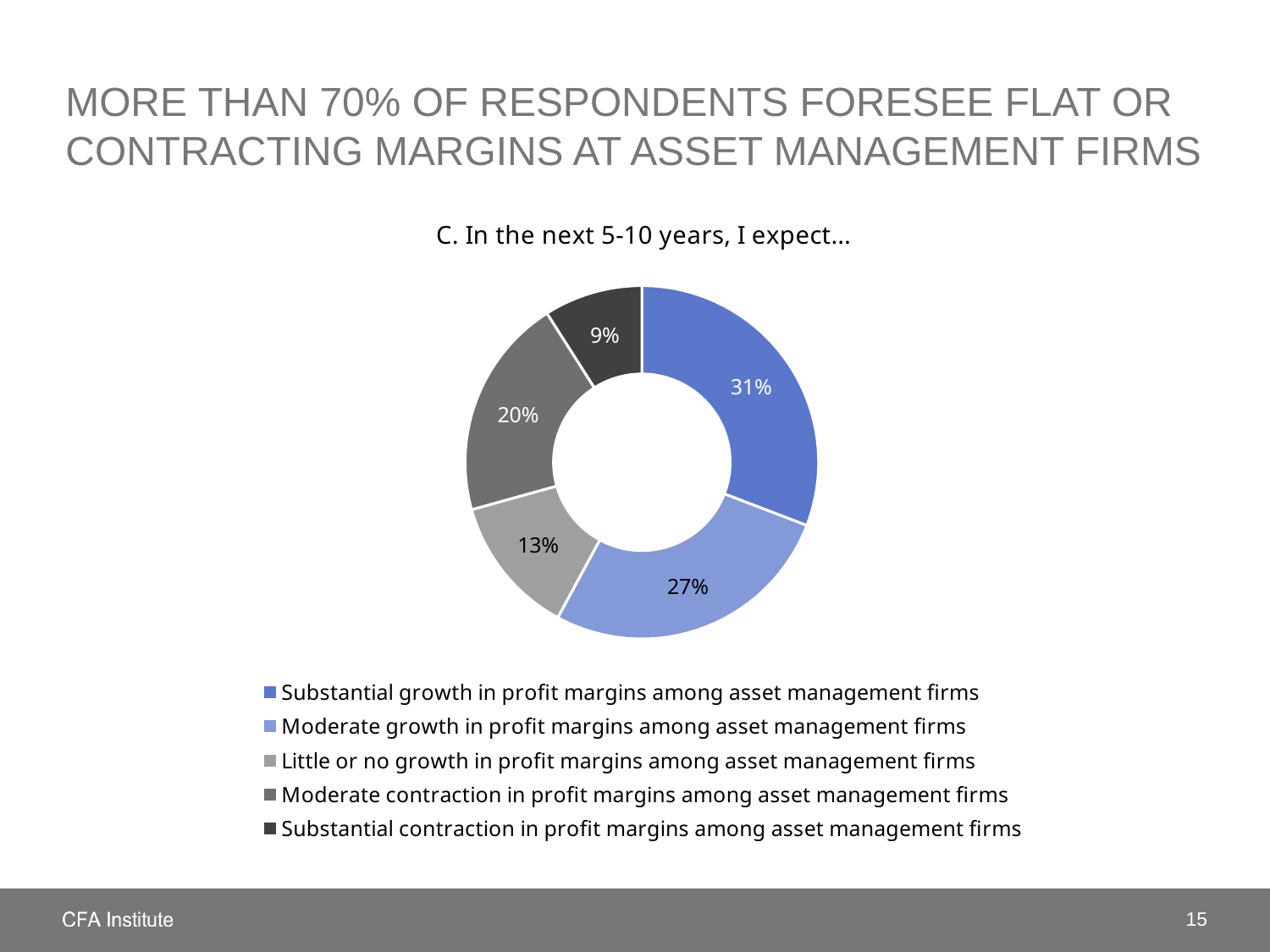
Which response has the largest share of the chart? Substantial growth in profit margins among asset management firms What share of respondents expect substantial contraction in profit margins among asset management firms? 9% What share of respondents expect moderate contraction in profit margins among asset management firms? 20% What share of respondents expect substantial growth in profit margins among asset management firms? 31% Which is larger: the share expecting moderate growth or the share expecting moderate contraction? Moderate growth How many response categories does the legend list? 5 What is the title of the chart? C. In the next 5-10 years, I expect… What kind of chart is shown on the slide? Doughnut chart Which response has the smallest share of the chart? Substantial contraction in profit margins among asset management firms What is the difference in percentage points between the share expecting moderate contraction and the share expecting substantial contraction? 11 percentage points What share of respondents expect moderate growth in profit margins among asset management firms? 27% What share of respondents expect little or no growth in profit margins among asset management firms? 13%